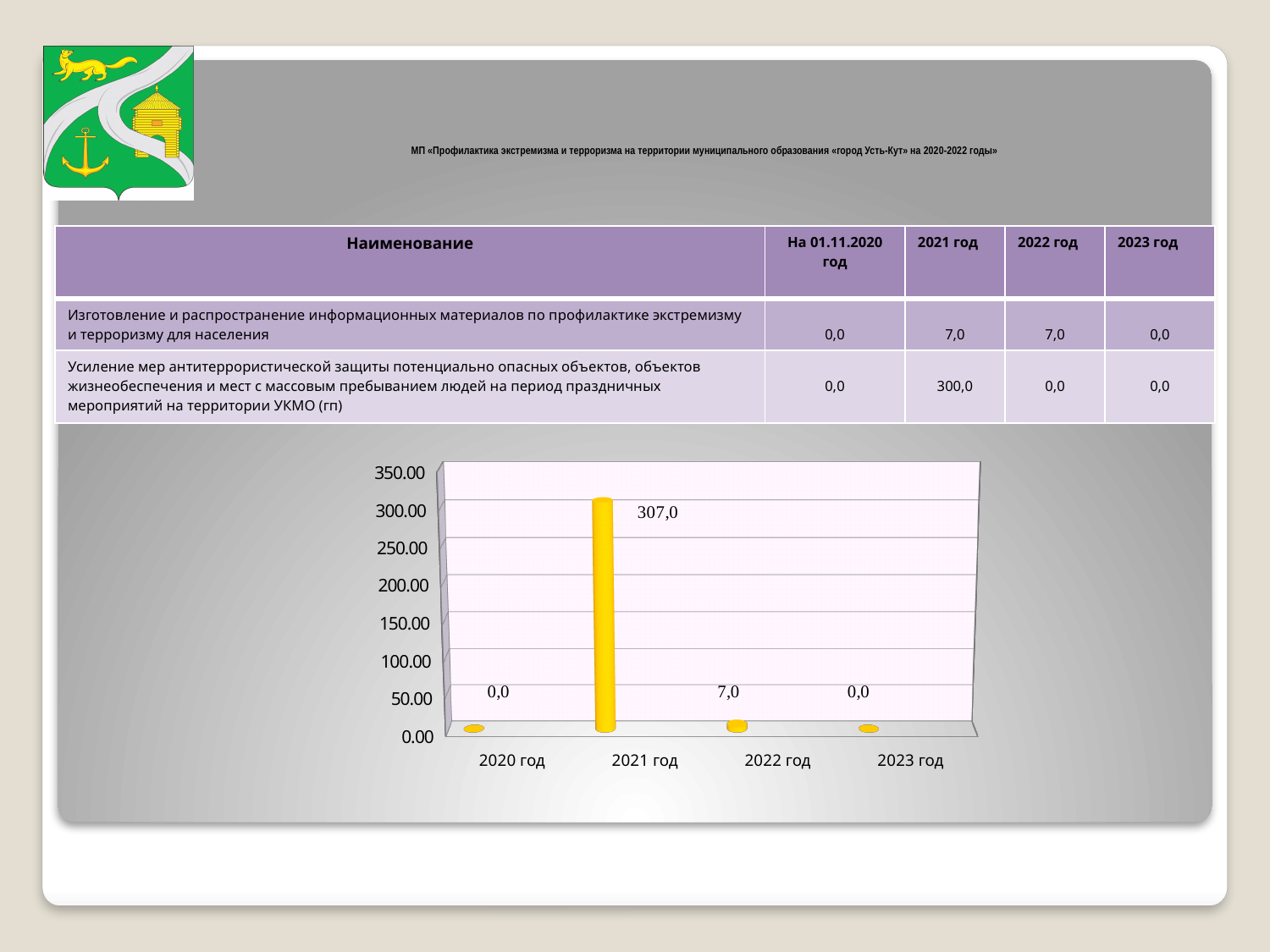
What kind of chart is shown on the slide? bar chart What is the value shown for 2022 год in the chart? 7,0 What is the value shown for 2020 год in the chart? 0,0 Which year has the highest value in the chart? 2021 год Which is larger in the chart, the value for 2021 год or the value for 2022 год? 2021 год What is the highest tick value shown on the vertical axis of the chart? 350.00 What is the value shown for 2021 год in the chart? 307,0 What is the difference between the values for 2021 год and 2022 год in the chart? 300,0 What is the value shown for 2023 год in the chart? 0,0 How many year categories are shown on the x axis of the chart? 4 Is the value for 2021 год in the chart greater or less than 300.00? greater Is the value for 2022 год in the chart greater or less than 50.00? less